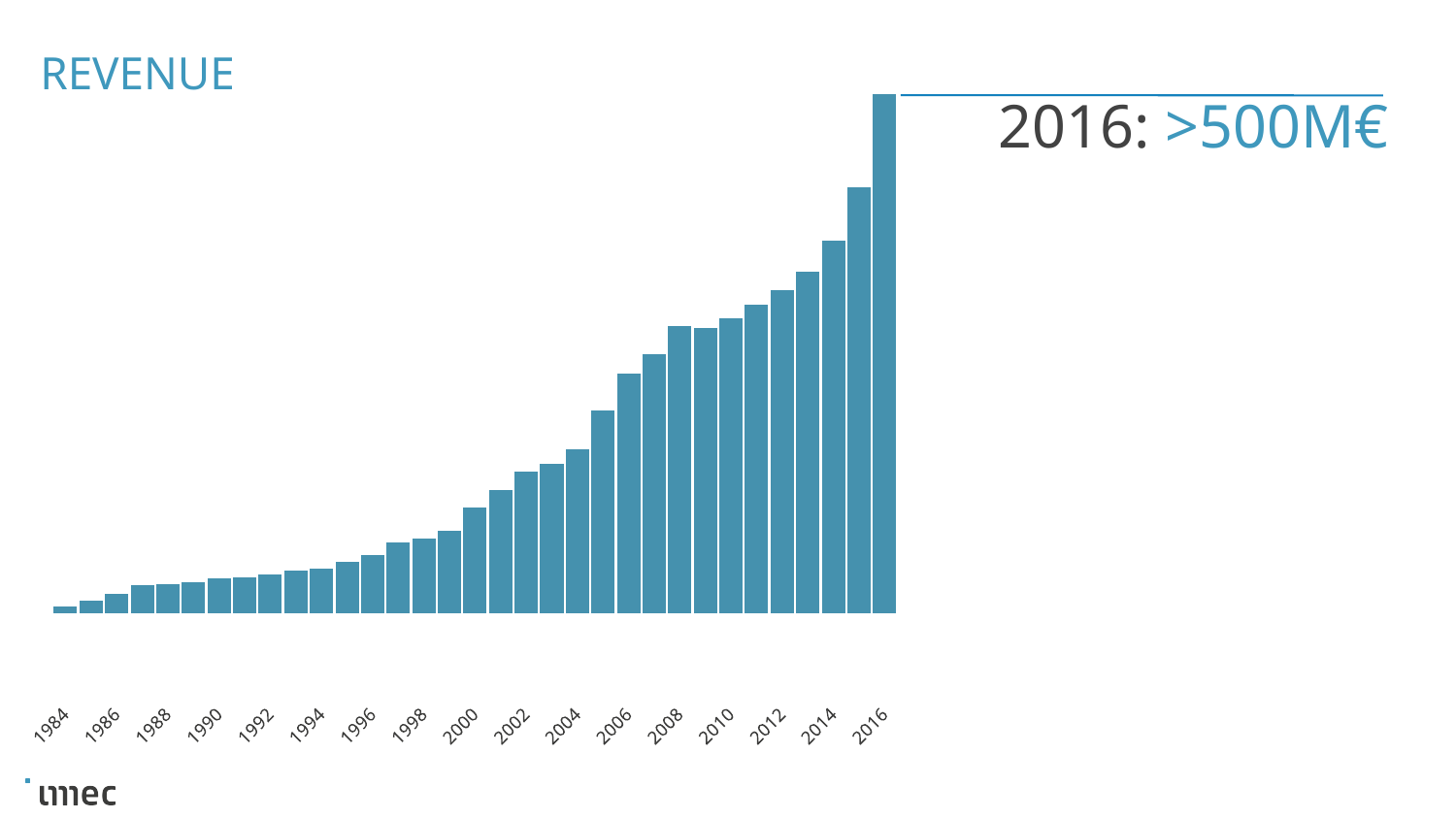
Which year has the larger revenue bar, 1990 or 2006? 2006 What is the title of the chart? REVENUE What kind of chart is shown on the slide? bar chart According to the annotation on the slide, what was the revenue in 2016? >500M€ Which year has the lowest revenue bar? 1984 How many year labels are shown on the x axis? 17 Which year has the larger revenue bar, 2015 or 2016? 2016 How many bars are plotted in the chart? 33 Do the revenue bars generally rise or fall from 1984 to 2016? rise What is the first year labelled on the x axis? 1984 Which year has the larger revenue bar, 2000 or 2010? 2010 Which year has the highest revenue bar? 2016